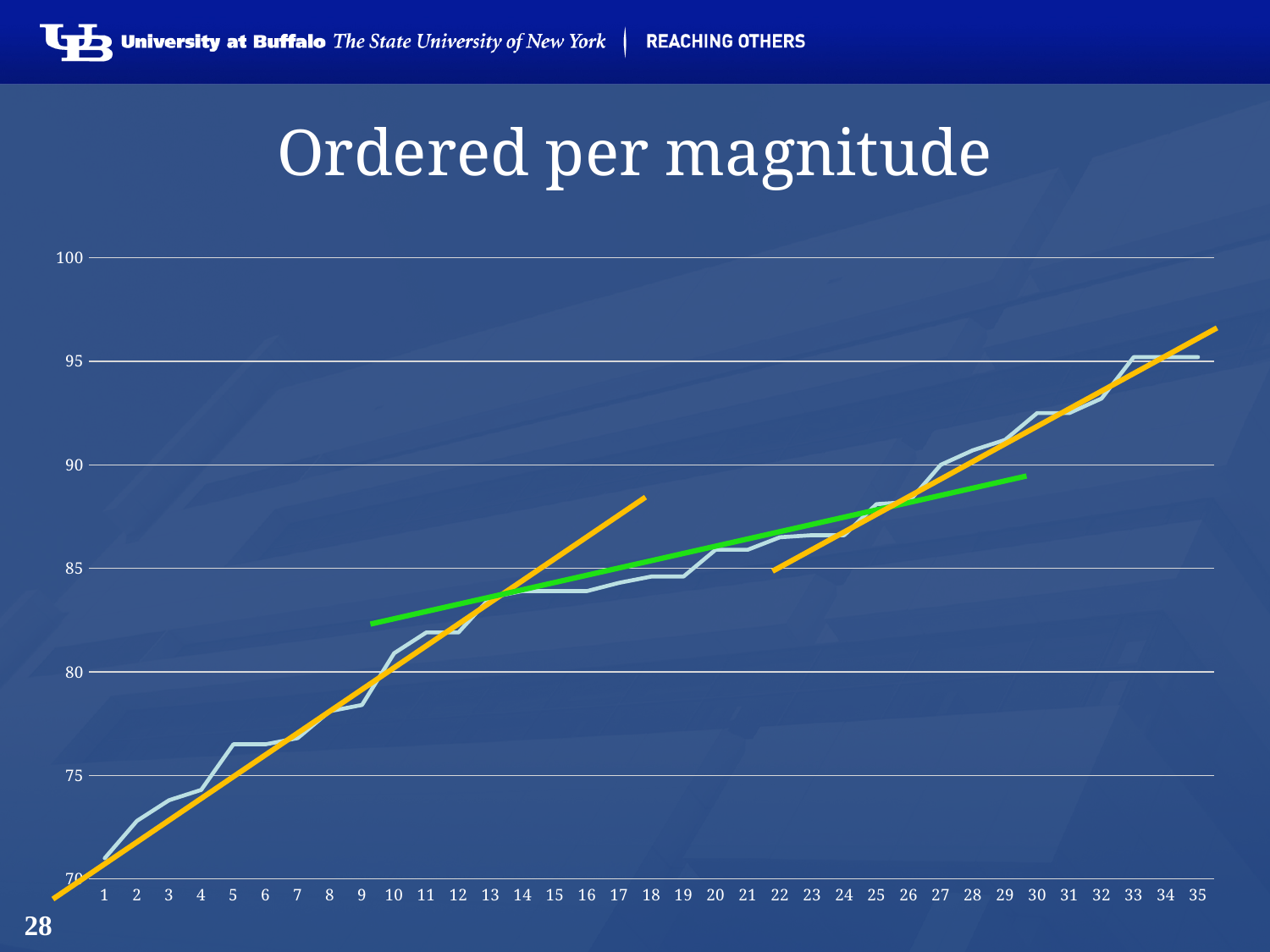
Is the value at point 30 greater or less than 90? greater What is the title of the chart on the slide? Ordered per magnitude Which x-axis point has the highest value on the light blue line? 33, 34 and 35 (tied) Which has the larger value on the light blue line, point 10 or point 20? 20 Is the value at point 5 greater or less than 75? greater What colours are the two straight trend lines drawn over the data line? orange and green Is the value at point 1 greater or less than 75? less Which x-axis point has the lowest value on the light blue line? 1 What kind of chart is shown on the slide? line chart How many points are plotted along the x axis of the chart? 35 Do the values of the light blue line rise or fall as the x axis goes from 1 to 35? rise